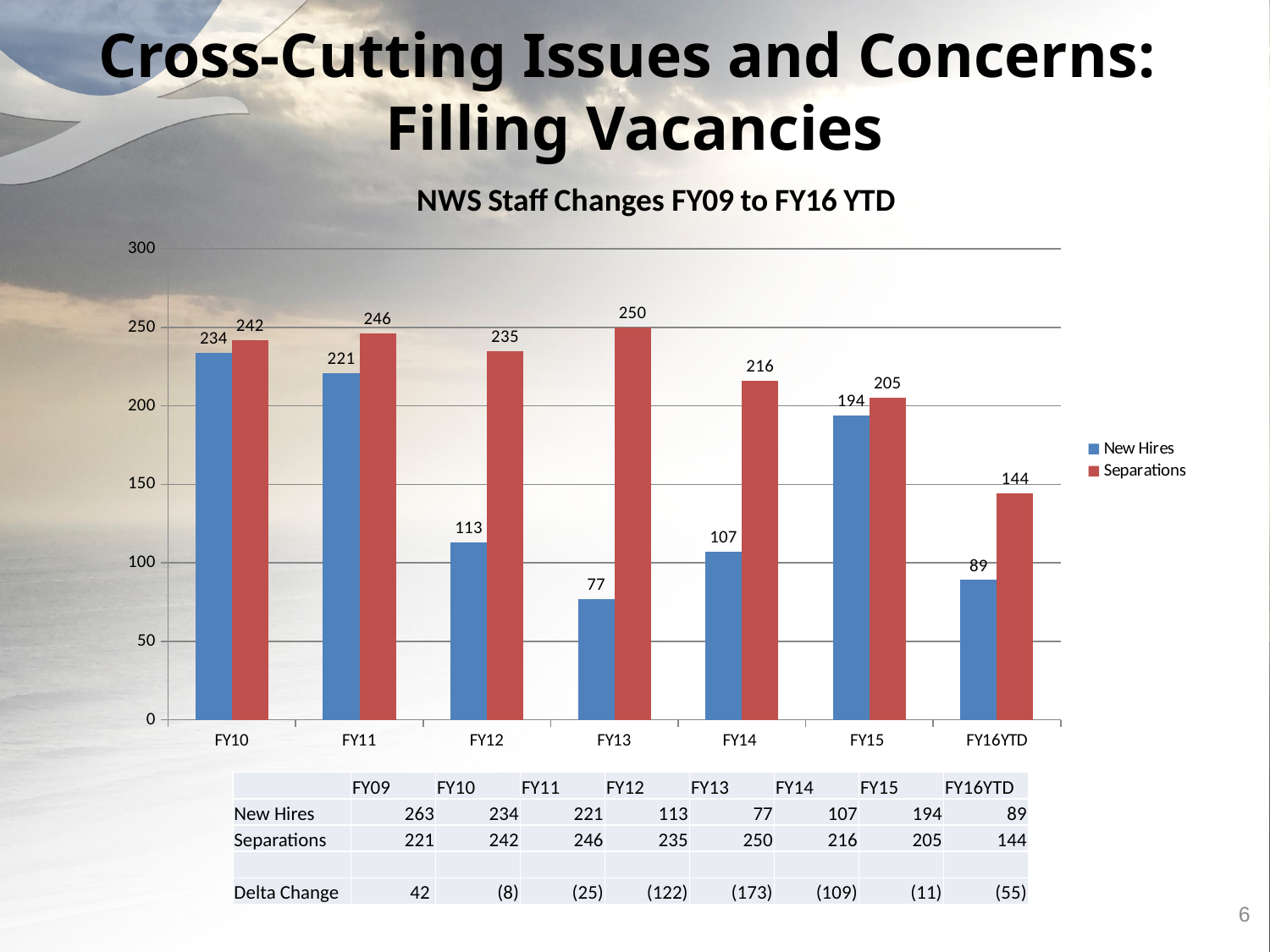
Which fiscal year has the lowest New Hires value in the chart? FY13 What kind of chart is shown on the slide? Bar chart How many fiscal year categories are shown on the x axis of the chart? 7 Which fiscal year has the highest Separations value in the chart? FY13 What is the value for New Hires in FY12? 113 What is the title of the chart? NWS Staff Changes FY09 to FY16 YTD Do the Separations values rise or fall from FY13 to FY16YTD? Fall Which is larger in FY15, New Hires or Separations? Separations How many series does the legend list? 2 What is the difference between Separations and New Hires in FY13? 173 What is the value for New Hires in FY16YTD? 89 What is the value for Separations in FY13? 250